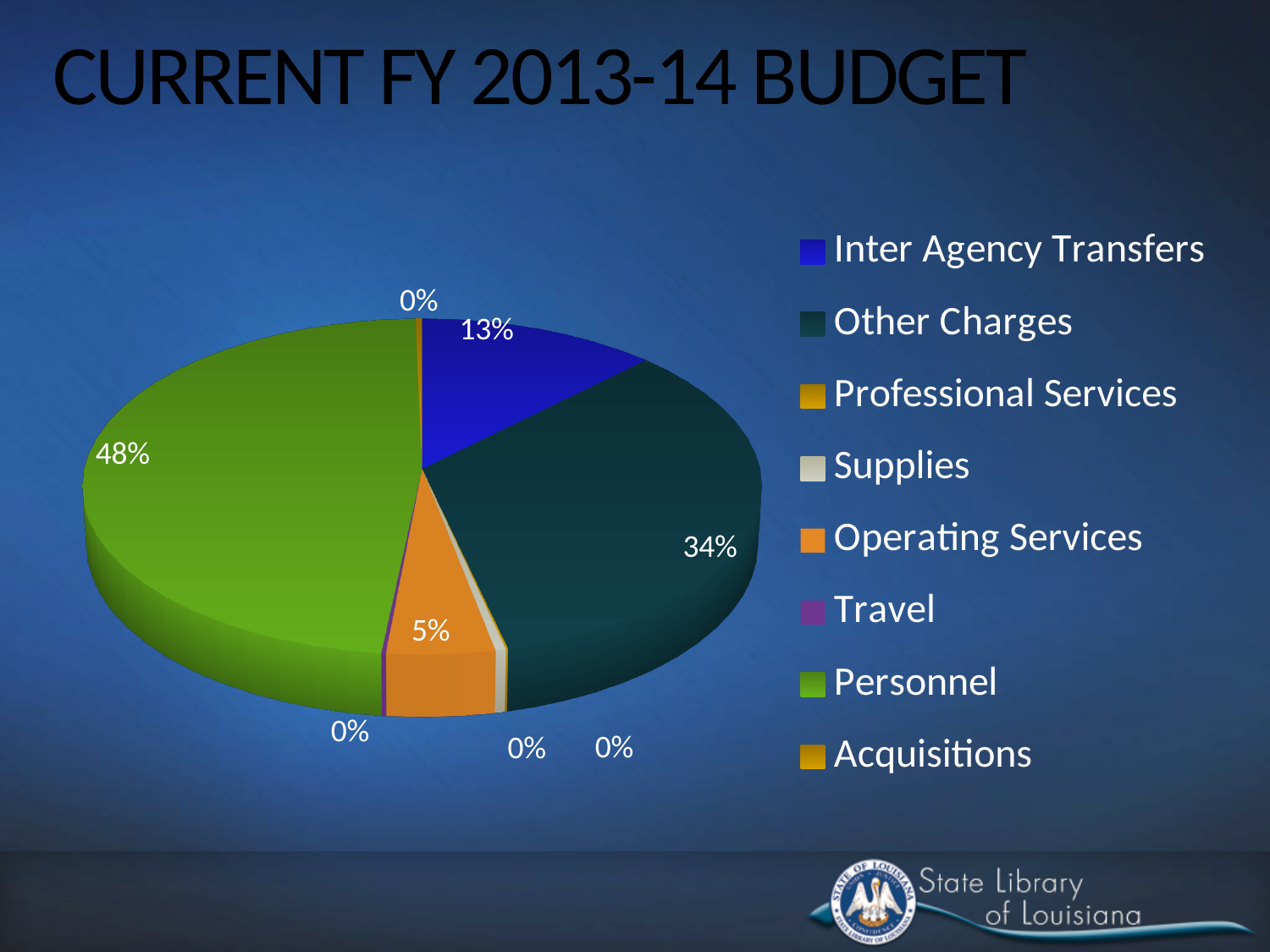
Which is larger, the share for Other Charges or the share for Inter Agency Transfers? Other Charges What share of the budget does Personnel account for? 48% Is the share for Personnel greater or less than 50%? less How many categories does the legend list? 8 What is the title of the chart on the slide? CURRENT FY 2013-14 BUDGET Which category has the largest share of the budget? Personnel Which category is shown in orange? Operating Services What percentage of the budget is Inter Agency Transfers? 13% What is the difference in percentage points between the Personnel share and the Other Charges share? 14 percentage points What percentage of the budget is Other Charges? 34% What percentage of the budget is Operating Services? 5% What kind of chart is shown on the slide? pie chart